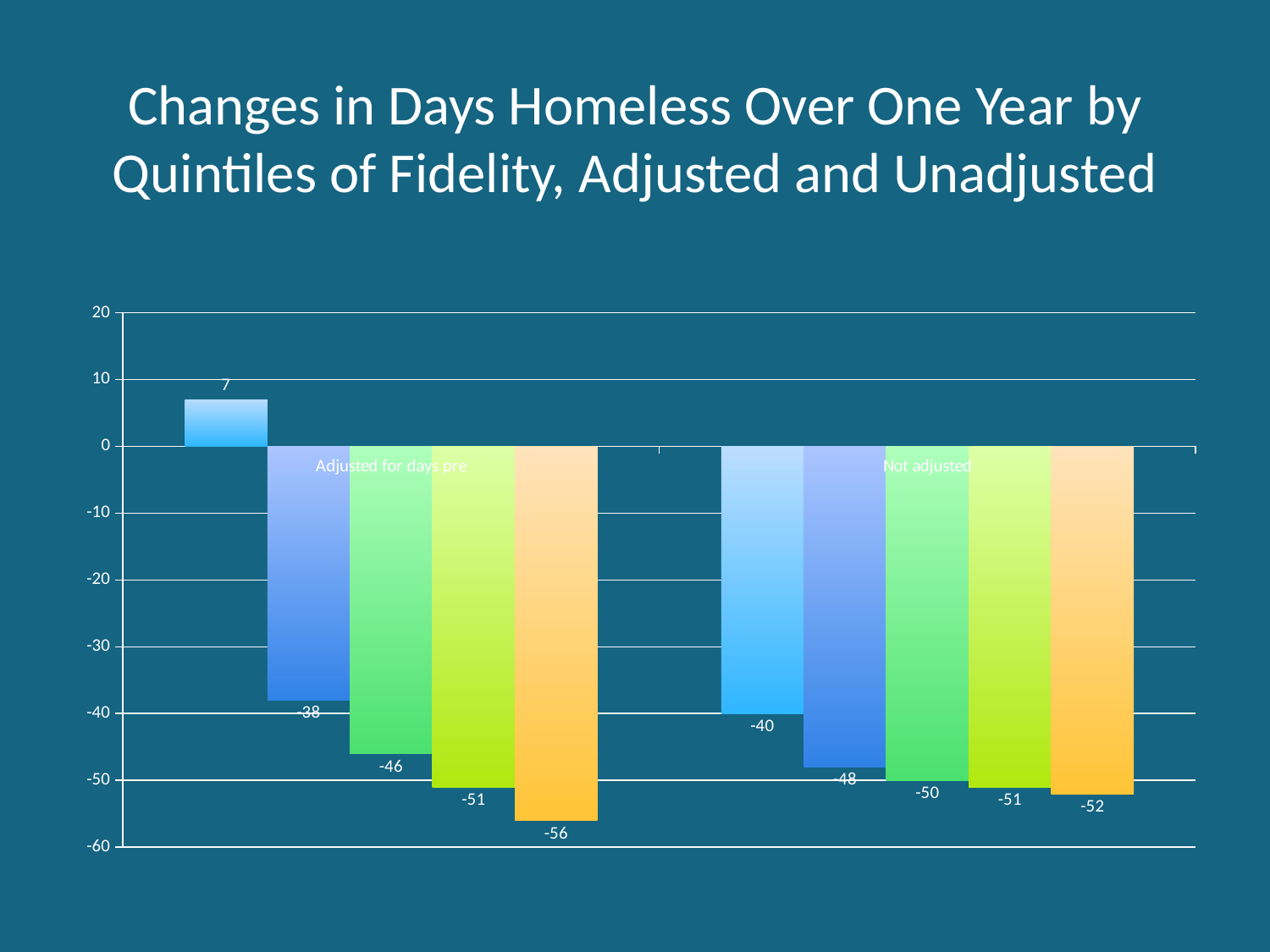
What is the value of the first (light blue) bar in the 'Adjusted for days pre' group? 7 How many bars are in the 'Adjusted for days pre' group? 5 Which is larger: the second (blue) bar in the 'Adjusted for days pre' group or the second (blue) bar in the 'Not adjusted' group? Adjusted for days pre (-38) What is the value of the green (third) bar in the 'Not adjusted' group? -50 What is the difference between the second bar (-38) and the third bar (-46) in the 'Adjusted for days pre' group? 8 Which bar has the highest value on the chart? the first (light blue) bar in the 'Adjusted for days pre' group, 7 What kind of chart is shown on the slide? bar chart Which bar has the lowest value on the chart? the orange (fifth) bar in the 'Adjusted for days pre' group, -56 Within the 'Adjusted for days pre' group, do the values rise or fall from left to right? fall What is the value of the last (orange) bar in the 'Not adjusted' group? -52 What is the title of the chart? Changes in Days Homeless Over One Year by Quintiles of Fidelity, Adjusted and Unadjusted How many groups of bars are shown on the x axis? 2